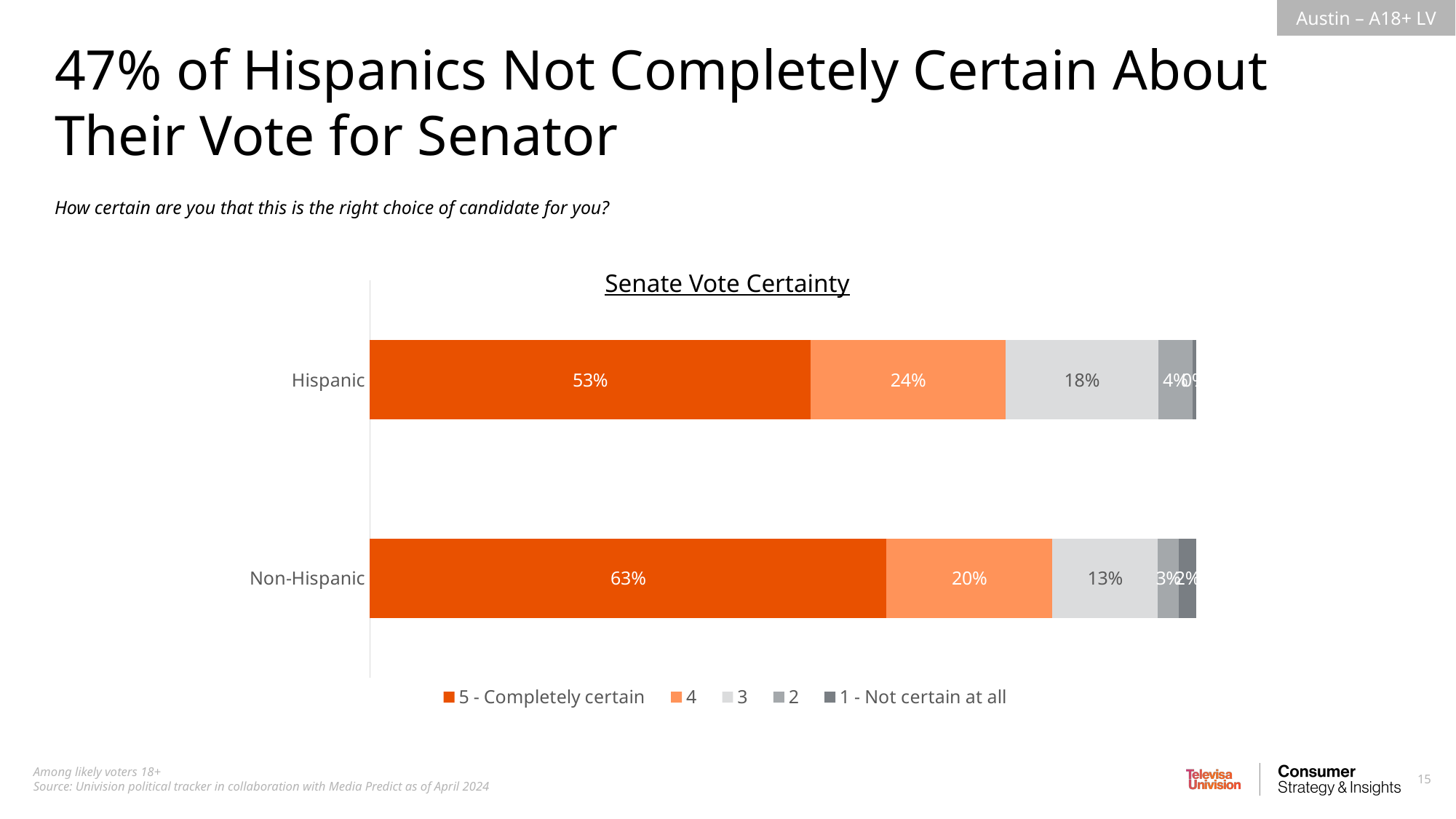
How many percentage points higher is the '5 - Completely certain' share for Non-Hispanic voters than for Hispanic voters? 10 percentage points What type of chart is shown on the slide? Stacked bar chart What is the value of the '3' segment for Non-Hispanic voters? 13% Which group has a higher share of '5 - Completely certain' voters, Hispanic or Non-Hispanic? Non-Hispanic How many groups (bars) are shown in the chart? 2 How many series does the legend list? 5 What is the difference between the '3' segment for Hispanic voters and the '3' segment for Non-Hispanic voters? 5 percentage points What percentage of Hispanic likely voters are '5 - Completely certain' about their Senate vote? 53% What percentage of Non-Hispanic likely voters are '5 - Completely certain' about their Senate vote? 63% What is the value of the '4' segment for Hispanic voters? 24% What is the value of the '4' segment for Non-Hispanic voters? 20% What is the value of the '3' segment for Hispanic voters? 18%